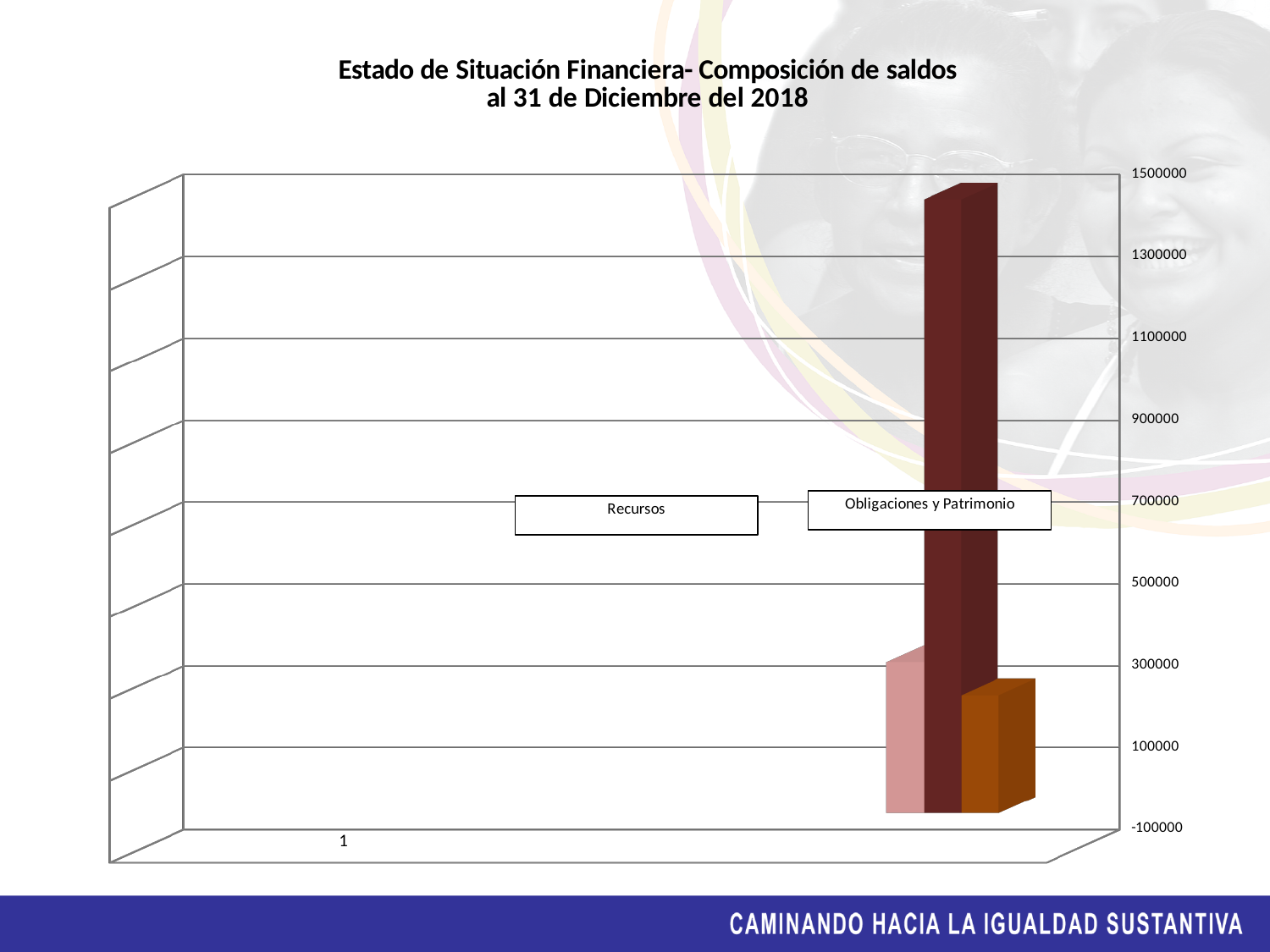
What is the label shown on the x axis of the chart? 1 Which bar is the shortest in the chart: the pink, the dark red, or the orange one? the orange bar What is the highest value shown on the vertical axis of the chart? 1500000 How many bars are plotted in the chart? 3 What is the title of the chart? Estado de Situación Financiera- Composición de saldos al 31 de Diciembre del 2018 Is the value of the dark red bar greater or less than 1300000? greater Is the value of the pink bar greater or less than 500000? less Which is larger, the value of the pink bar or the value of the orange bar? the pink bar What kind of chart is shown on the slide? bar chart Which bar is the tallest in the chart: the pink, the dark red, or the orange one? the dark red bar How many categories are shown on the x axis of the chart? 1 Is the value of the orange bar greater or less than 500000? less